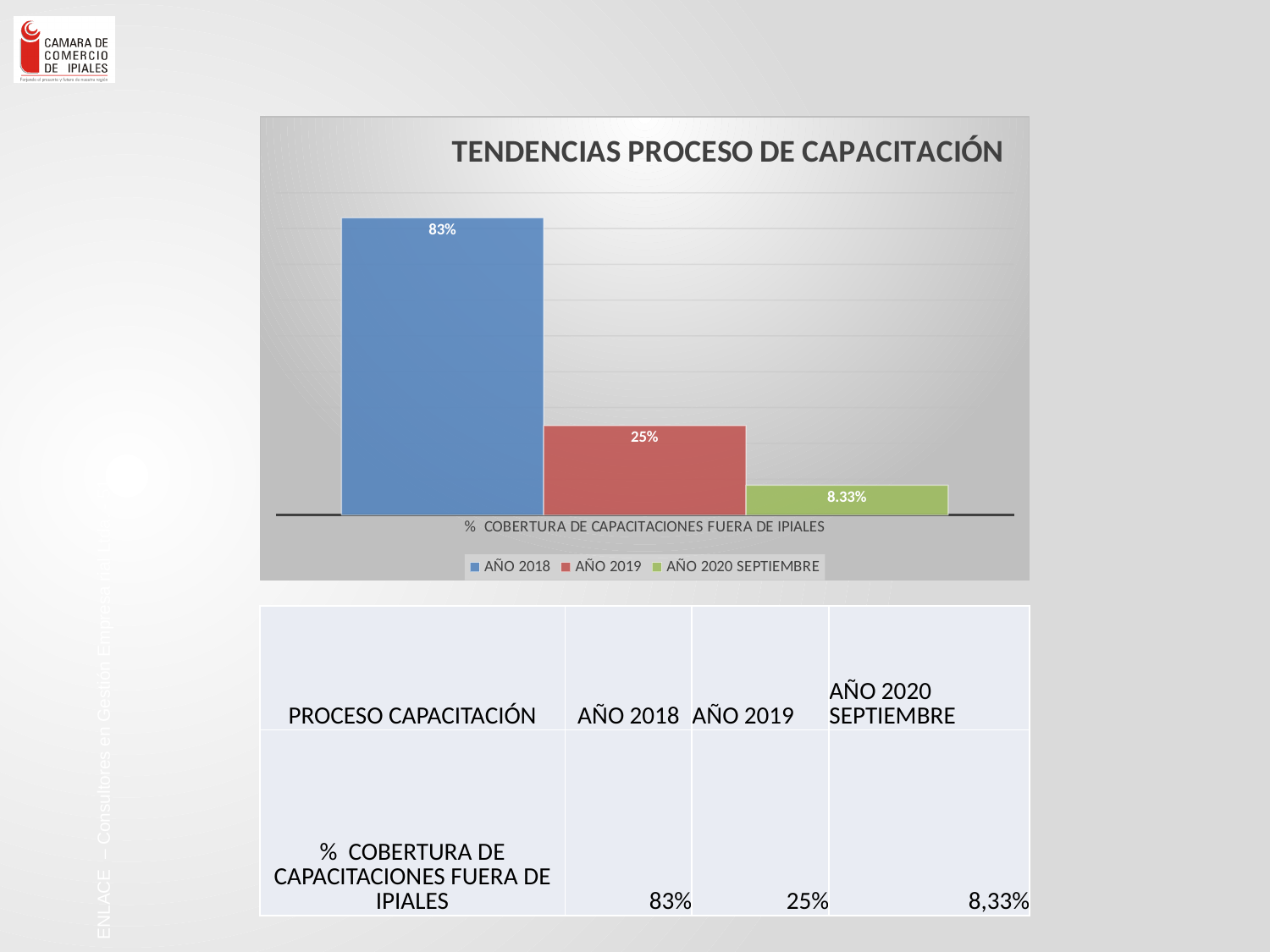
What is the value for AÑO 2020 SEPTIEMBRE in the chart? 8.33% How many series does the legend list? 3 Which is larger, the value for AÑO 2019 or the value for AÑO 2020 SEPTIEMBRE? AÑO 2019 Which series has the lowest value in the chart? AÑO 2020 SEPTIEMBRE What is the title of the chart? TENDENCIAS PROCESO DE CAPACITACIÓN Which series has the highest value in the chart? AÑO 2018 What is the difference between the AÑO 2018 and AÑO 2019 values? 58% What colour is the bar for AÑO 2019? Red What kind of chart is shown on the slide? Bar chart What is the value for AÑO 2018 in the chart? 83% Do the values rise or fall from AÑO 2018 to AÑO 2020 SEPTIEMBRE? Fall What is the value for AÑO 2019 in the chart? 25%